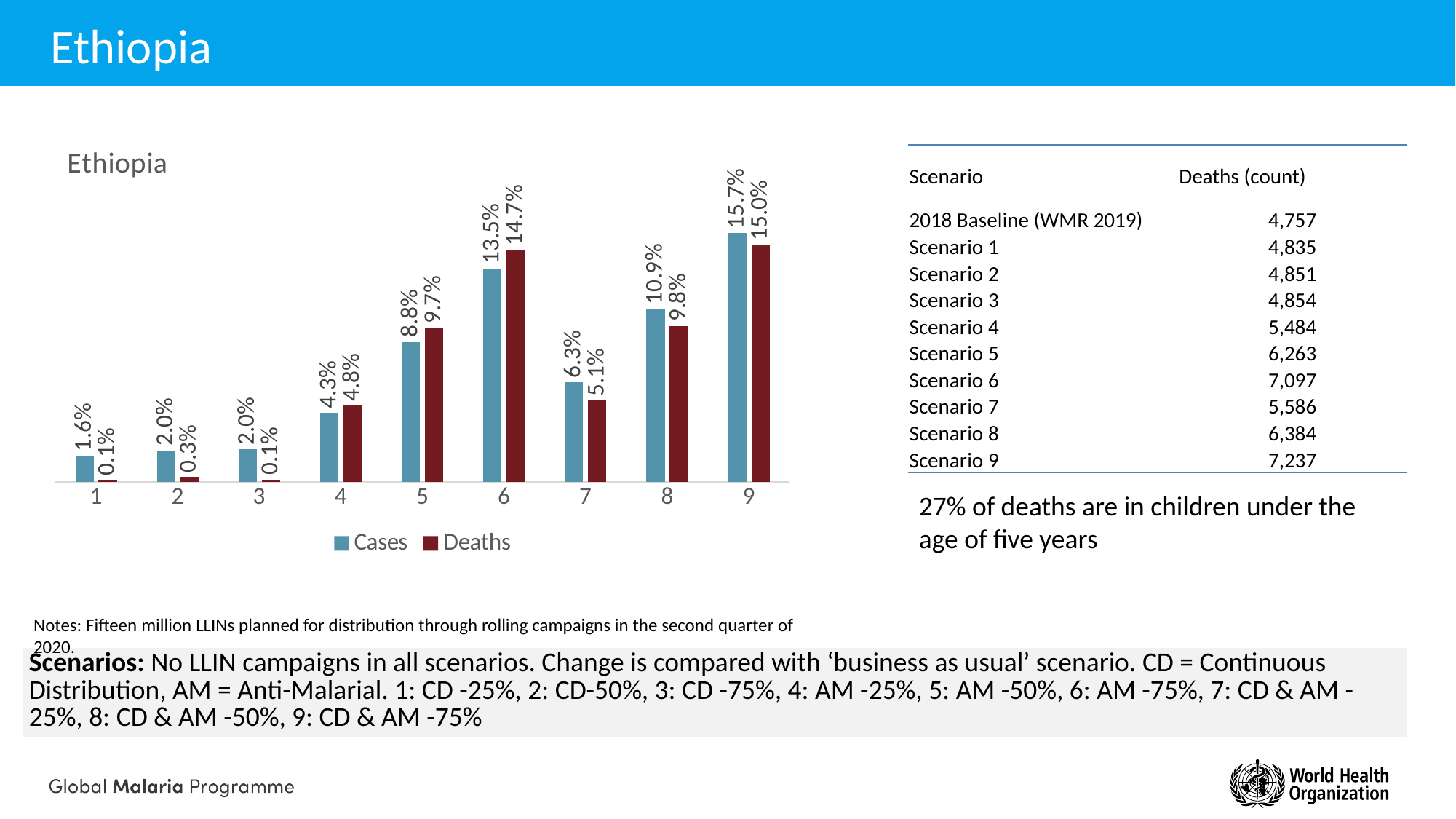
What is the Deaths value for scenario 2? 0.3% What is the Deaths value for scenario 9? 15.0% Which is larger for scenario 5, the Cases value or the Deaths value? Deaths What is the title of the chart? Ethiopia What is the Cases value for scenario 6? 13.5% Do the Cases values rise or fall from scenario 4 to scenario 6? Rise Which scenario has the highest Cases value? 9 Which scenario has the lowest Cases value? 1 What is the difference between the Cases and Deaths values for scenario 7? 1.2% How many series does the chart legend list? 2 How many scenarios are shown on the x axis of the chart? 9 What kind of chart is shown on the slide? Bar chart